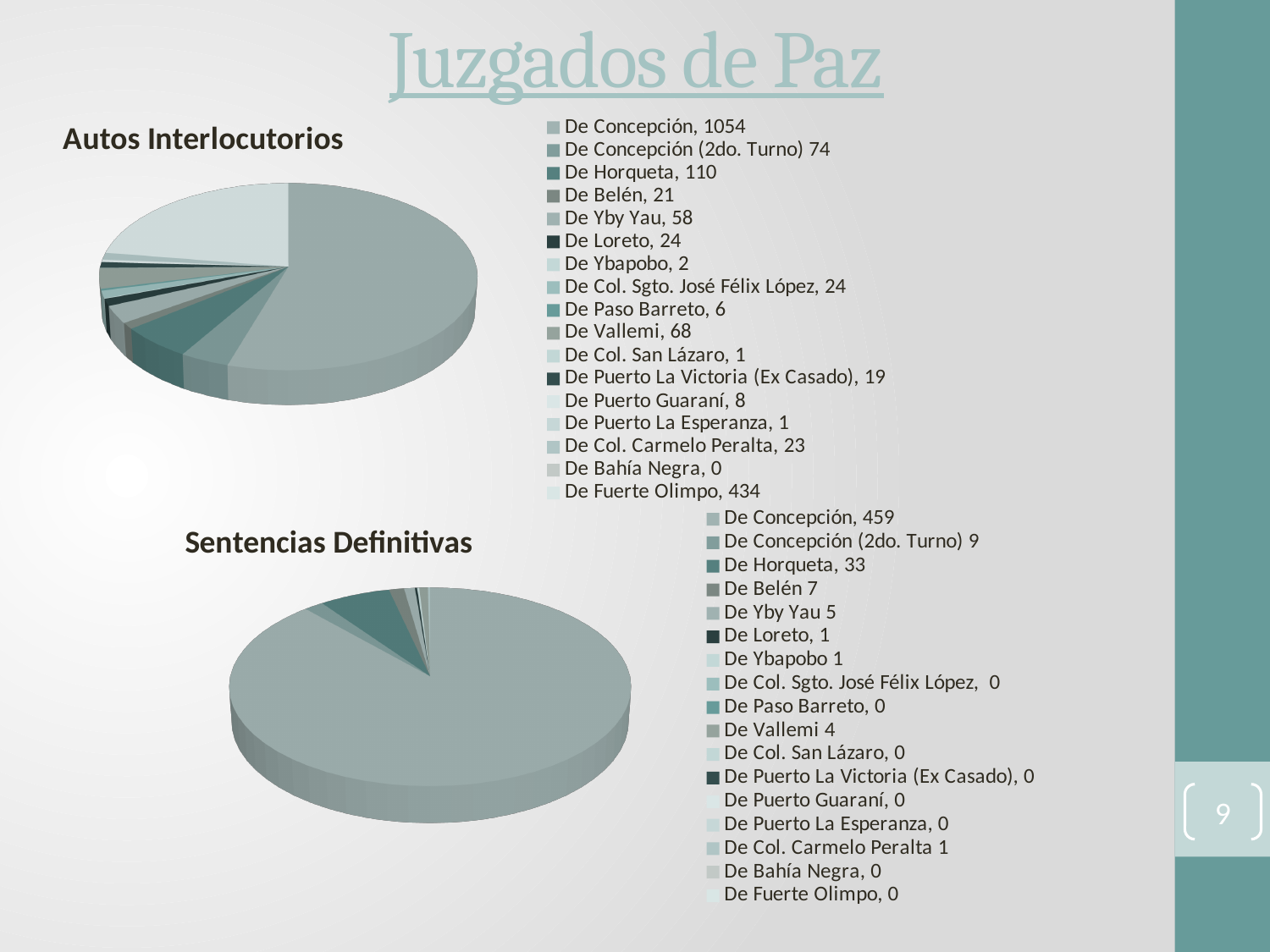
In the Autos Interlocutorios chart, what is the difference between De Horqueta and De Vallemi? 42 What is the title of the slide? Juzgados de Paz In the Autos Interlocutorios chart, what is the value for De Fuerte Olimpo? 434 How many categories does the legend of the Sentencias Definitivas chart list? 17 In the Sentencias Definitivas chart, what share of the total does De Concepción represent? 88.3% In the Sentencias Definitivas chart, what is the difference between De Concepción and De Concepción (2do. Turno)? 450 In the Autos Interlocutorios chart, which is larger: De Yby Yau or De Concepción (2do. Turno)? De Concepción (2do. Turno) In the Sentencias Definitivas chart, which category has the highest value? De Concepción What kind of chart is the Autos Interlocutorios chart? Pie chart In the Sentencias Definitivas chart, what is the value for De Horqueta? 33 In the Autos Interlocutorios chart, which category has the lowest value? De Bahía Negra In the Autos Interlocutorios chart, what is the value for De Concepción? 1054